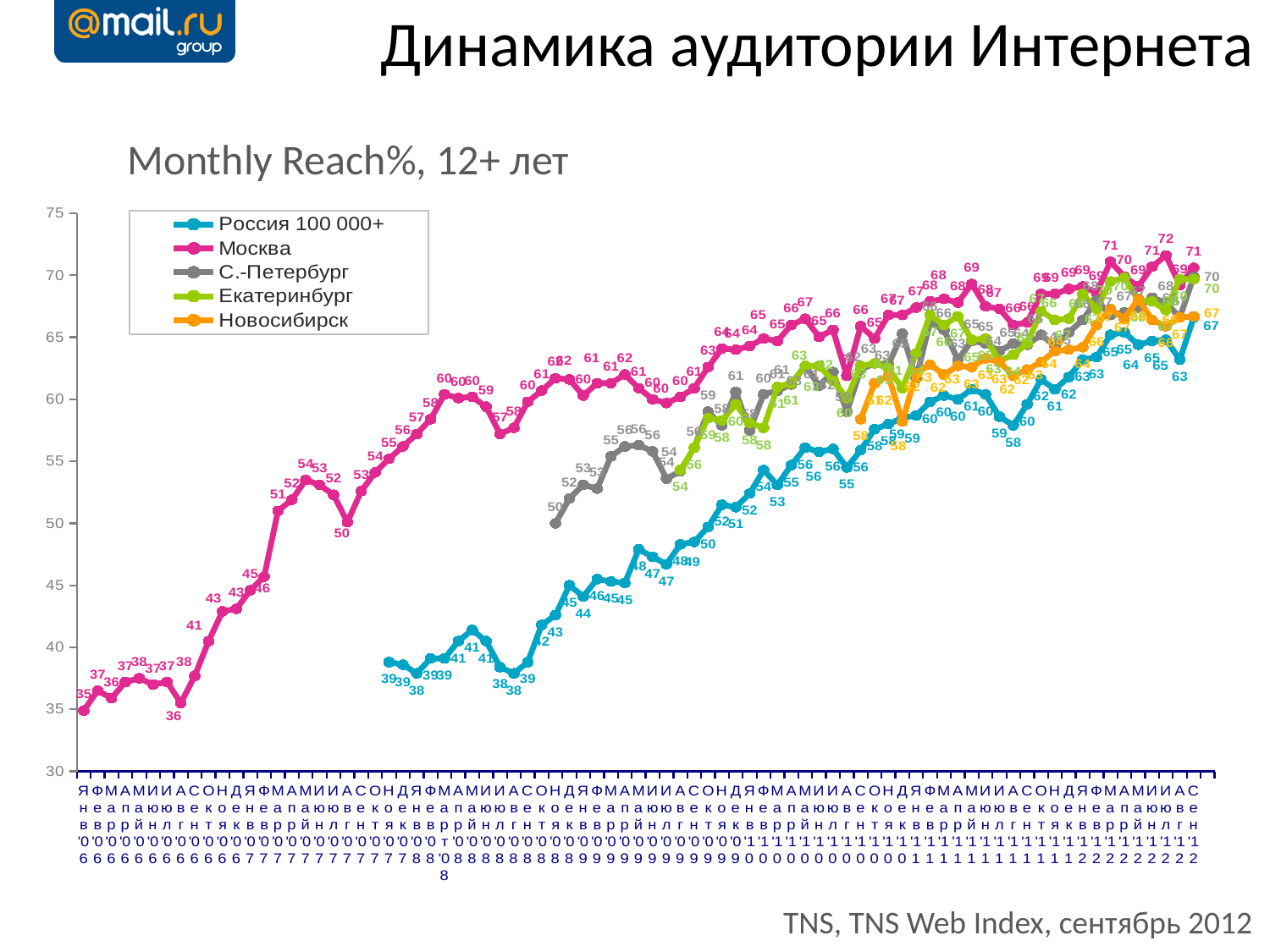
Which series reaches the highest value on the chart? Москва Does the Россия 100 000+ line generally rise or fall along the x axis? rise What is the difference between the highest (72) and the first (35) value for Москва? 37 What is the subtitle of the chart? Monthly Reach%, 12+ лет What is the highest labelled value for Москва? 72 What is the last plotted value for Россия 100 000+? 67 Which series are listed in the legend? Россия 100 000+, Москва, С.-Петербург, Екатеринбург, Новосибирск What is the first plotted value for С.-Петербург? 50 How many series does the legend list? 5 What is the first plotted value for Москва? 35 What kind of chart is shown on the slide? line chart Which series is the lowest line across the chart? Россия 100 000+